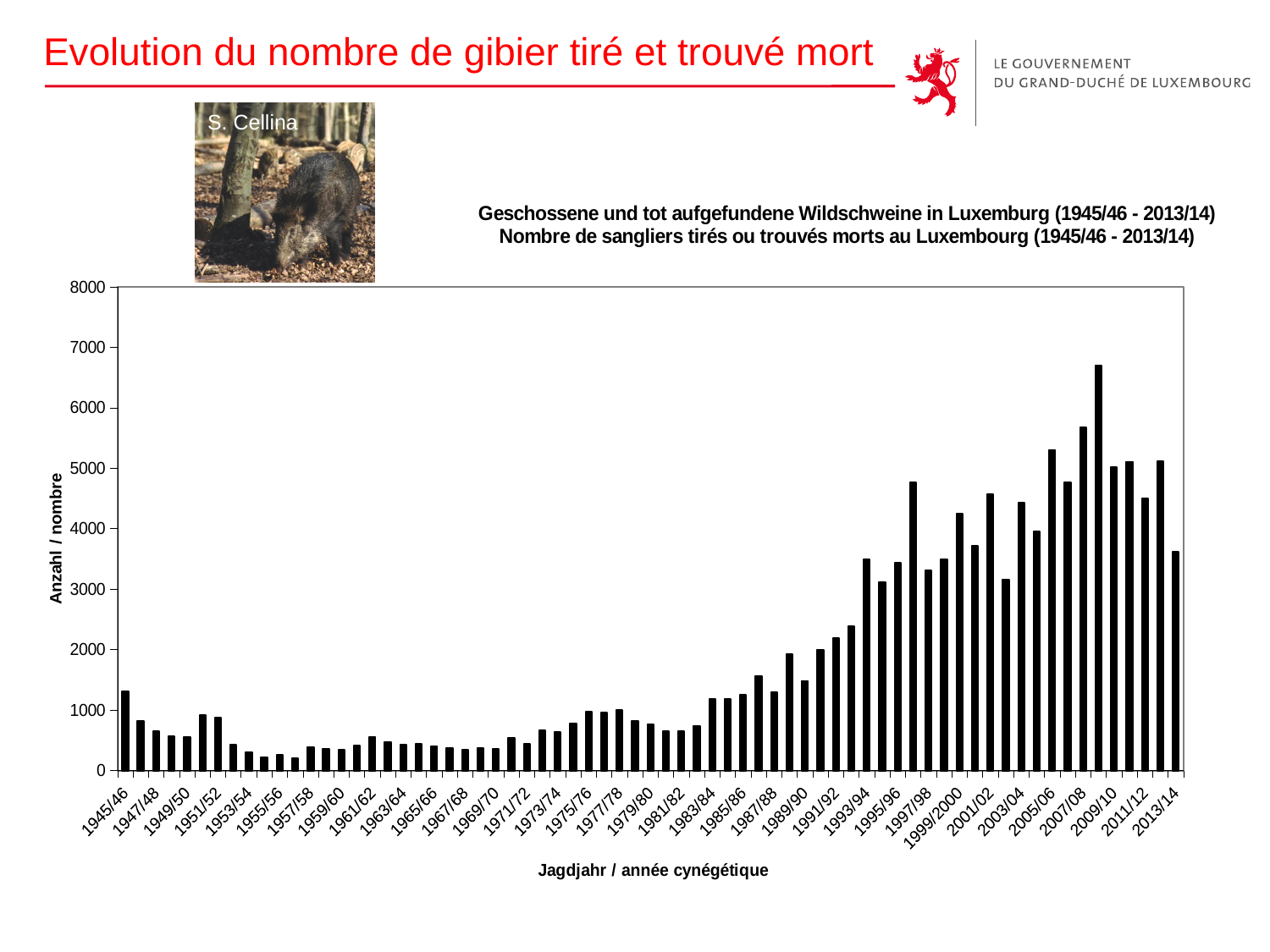
Is the value for 1993/94 greater or less than 3000? greater Overall, do the values rise or fall from 1945/46 to 2013/14? rise Is the value for 1985/86 greater or less than 1000? greater Is the value for 1945/46 greater or less than 1000? greater What kind of chart is shown on the slide? bar chart What is the title of the chart (French line)? Nombre de sangliers tirés ou trouvés morts au Luxembourg (1945/46 - 2013/14) Which has the larger value, 1945/46 or 1947/48? 1945/46 Which has the larger value, 2013/14 or 1945/46? 2013/14 What is the label of the x axis? Jagdjahr / année cynégétique How many hunting years (bars) are plotted, from 1945/46 to 2013/14? 69